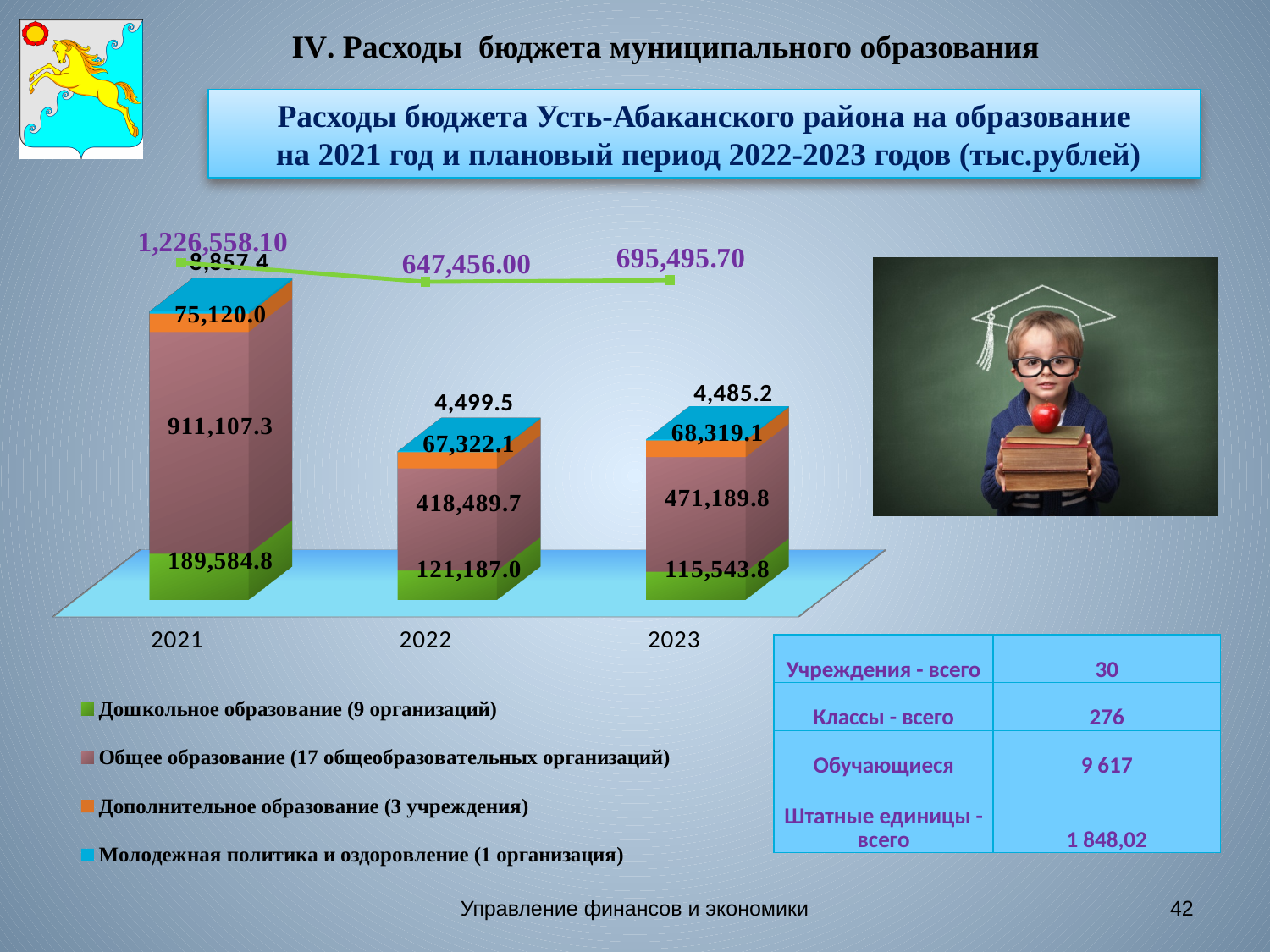
Which year has the highest total expenditure on education? 2021 Which year has the lowest total expenditure on education? 2022 What is the value for Дошкольное образование in 2022? 121,187.0 What is the value for Общее образование in 2021? 911,107.3 What kind of chart is used to show the education expenditures? Stacked bar chart What is the total shown above the bar for 2023? 695,495.70 How many years are shown on the x axis of the chart? 3 Which is larger, the Дошкольное образование value for 2021 or for 2023? 2021 How many series does the chart legend list? 4 What is the value for Дополнительное образование in 2023? 68,319.1 What is the value for Молодежная политика и оздоровление in 2022? 4,499.5 What is the difference between the Общее образование values for 2023 and 2022? 52,700.1